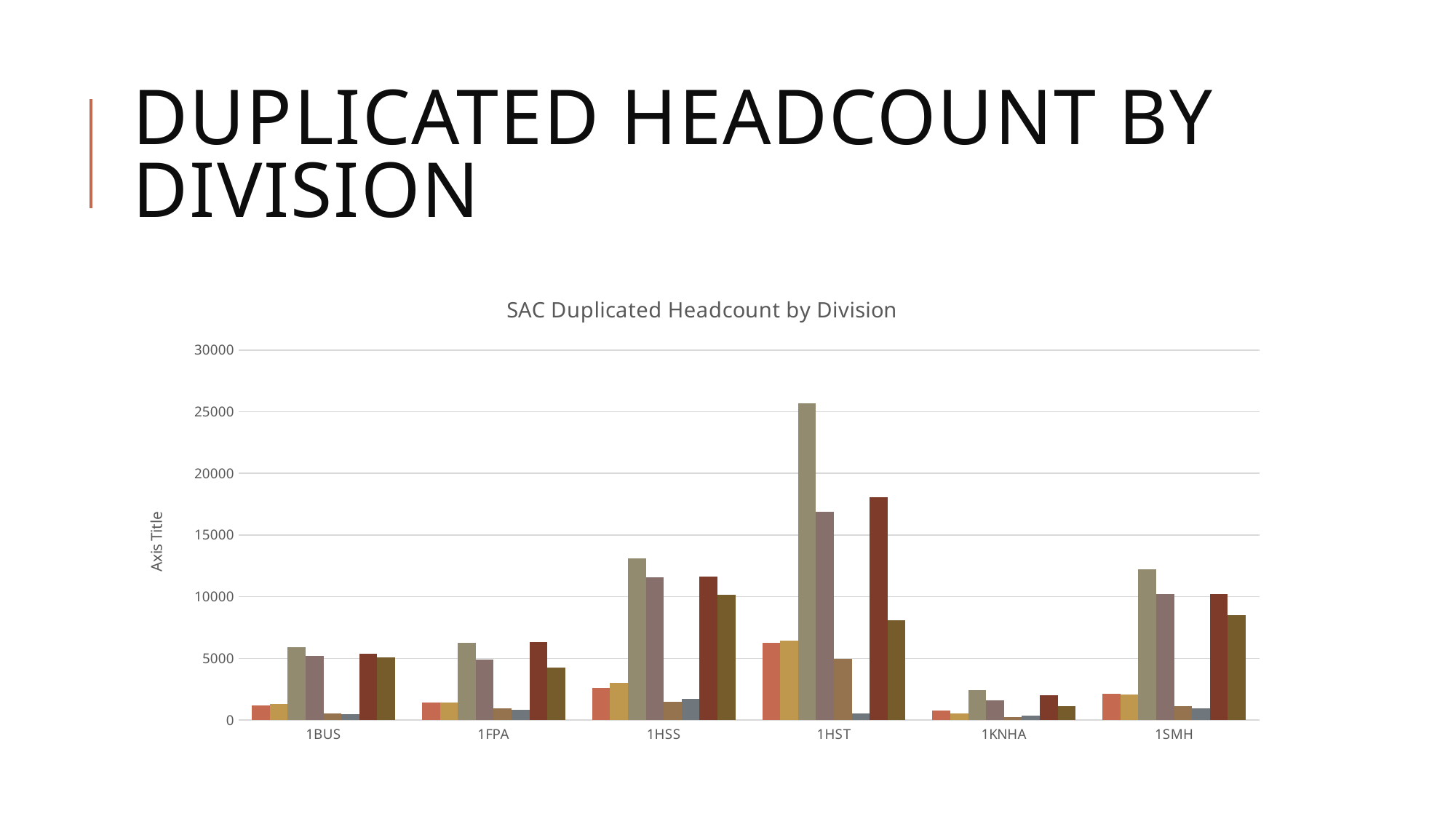
How many divisions are shown along the x axis of the chart? 6 What is the label shown on the vertical axis of the chart? Axis Title How many bars are plotted for each division in the chart? 8 Is the tallest bar for 1KNHA greater or less than 5000? less Which division has a taller maximum bar, 1HST or 1HSS? 1HST Is the tallest bar for 1HST greater or less than 20000? greater What is the title of the chart? SAC Duplicated Headcount by Division Which division has the lowest bars overall in the chart? 1KNHA Is the tallest bar for 1SMH greater or less than 15000? less What kind of chart is shown on the slide? bar chart Which division has the tallest bar in the chart? 1HST